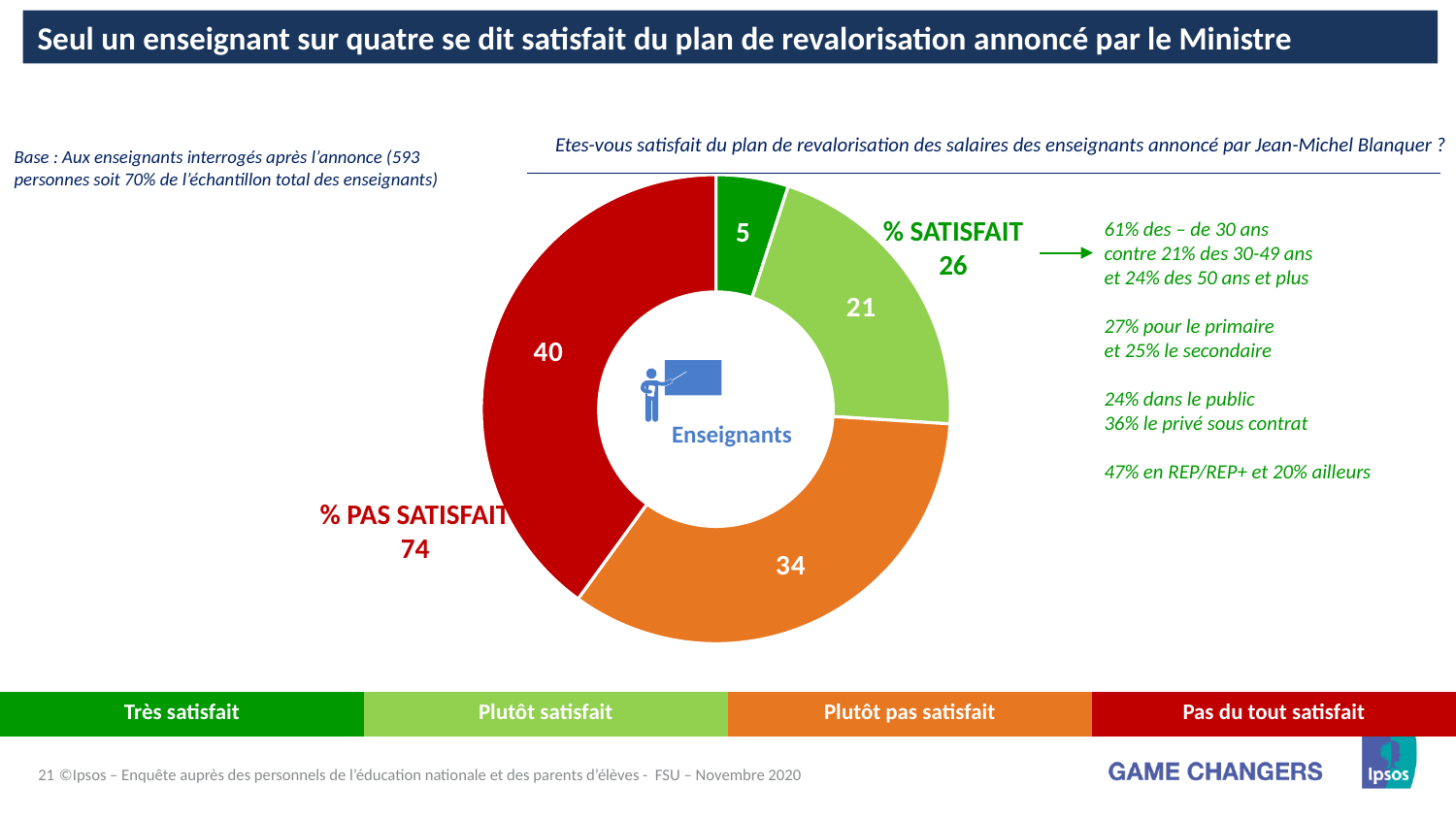
What is the value for "Plutôt pas satisfait" in the donut chart? 34 Which category has the smallest slice in the donut chart? Très satisfait What kind of chart is shown on the slide? Donut (pie) chart What is the total "% SATISFAIT" shown next to the donut chart? 26 What is the value for "Pas du tout satisfait" in the donut chart? 40 How many categories does the legend of the donut chart list? 4 Which is larger: the value for "Plutôt satisfait" or the value for "Plutôt pas satisfait"? Plutôt pas satisfait What is the total "% PAS SATISFAIT" shown next to the donut chart? 74 What is the value for "Plutôt satisfait" in the donut chart? 21 Which category has the largest slice in the donut chart? Pas du tout satisfait What is the value for "Très satisfait" in the donut chart? 5 What is the difference between the values for "Pas du tout satisfait" and "Plutôt pas satisfait"? 6